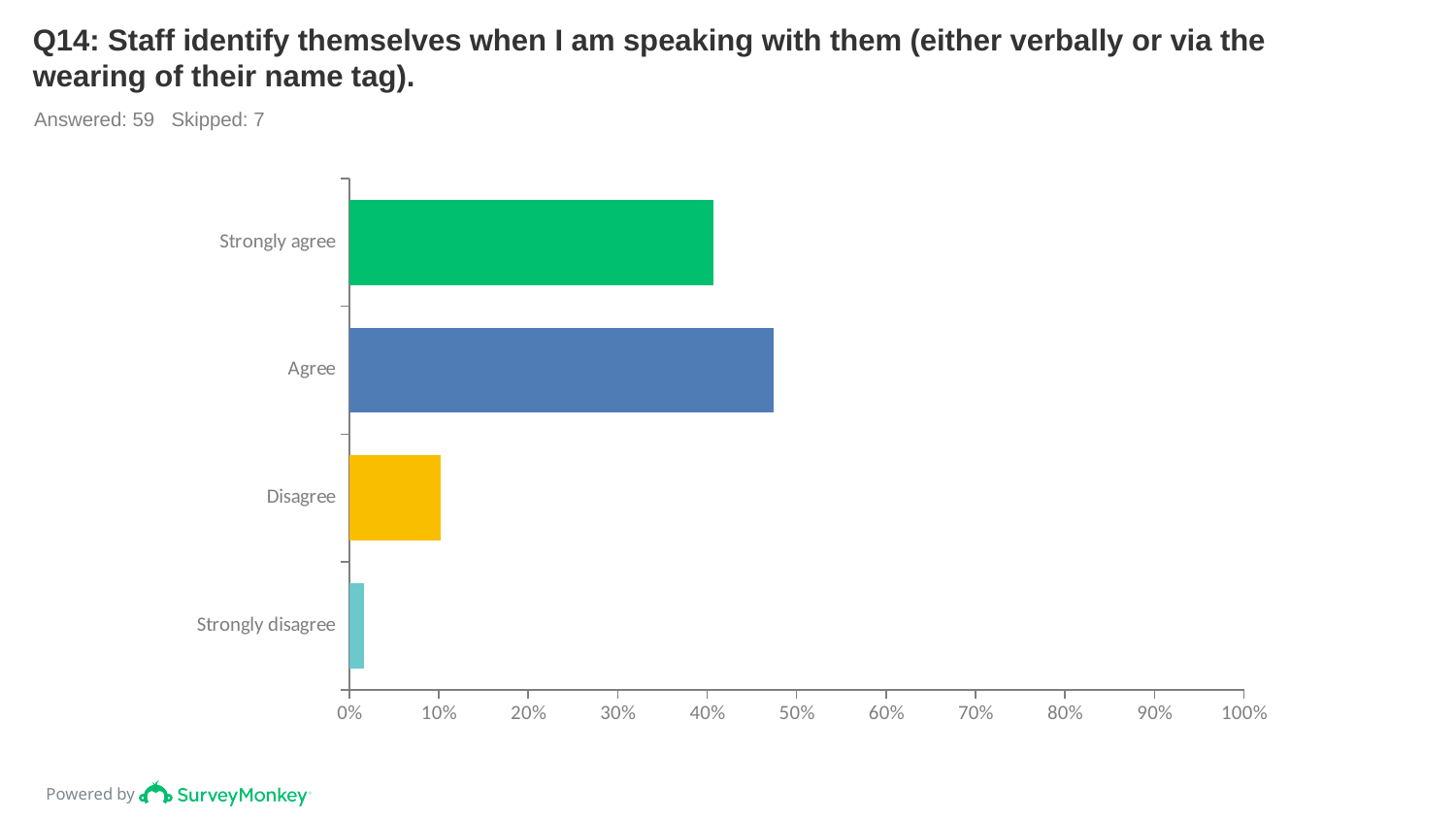
How many response categories are shown in the chart? 4 Is the value for Strongly agree greater or less than 30%? greater Which response category has the highest value? Agree How many respondents answered this question according to the slide? 59 Is the value for Agree greater or less than 40%? greater Which is larger, the value for Disagree or the value for Strongly disagree? Disagree Which is larger, the value for Strongly agree or the value for Disagree? Strongly agree What kind of chart is shown on the slide? bar chart Is the value for Agree greater or less than 60%? less Which response category has the lowest value? Strongly disagree